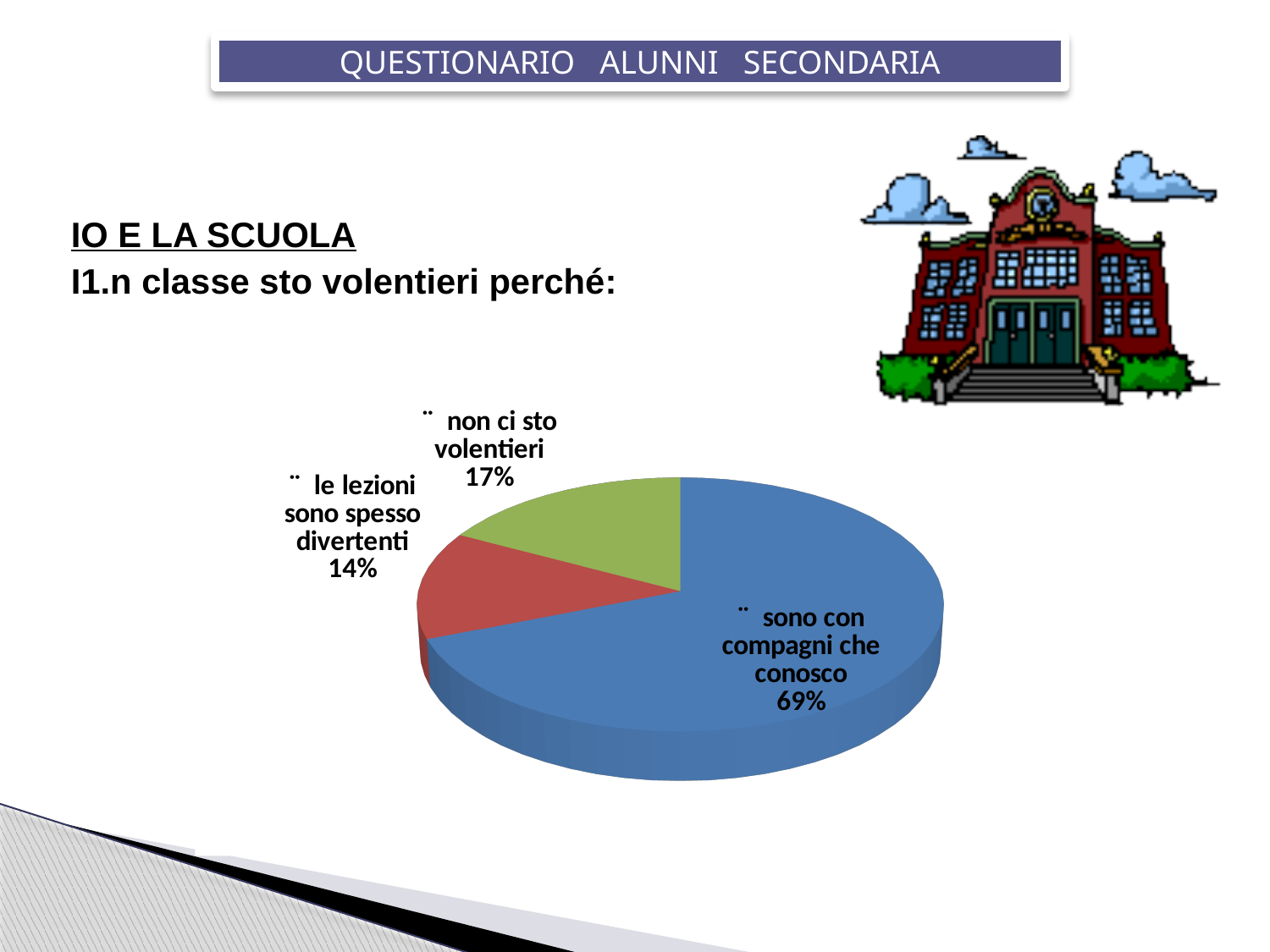
What colour is the slice for "non ci sto volentieri"? green Which is larger: the slice for "non ci sto volentieri" or the slice for "le lezioni sono spesso divertenti"? non ci sto volentieri Which slice of the pie is the largest? sono con compagni che conosco What is the difference in percentage points between "non ci sto volentieri" and "le lezioni sono spesso divertenti"? 3 What percentage of the pie is for "non ci sto volentieri"? 17% What percentage of the pie is for "le lezioni sono spesso divertenti"? 14% Which slice of the pie is the smallest? le lezioni sono spesso divertenti What kind of chart is shown on the slide? pie chart What is the difference in percentage points between "sono con compagni che conosco" and "non ci sto volentieri"? 52 What percentage of the pie is for "sono con compagni che conosco"? 69% How many slices does the pie chart have? 3 What colour is the slice for "sono con compagni che conosco"? blue